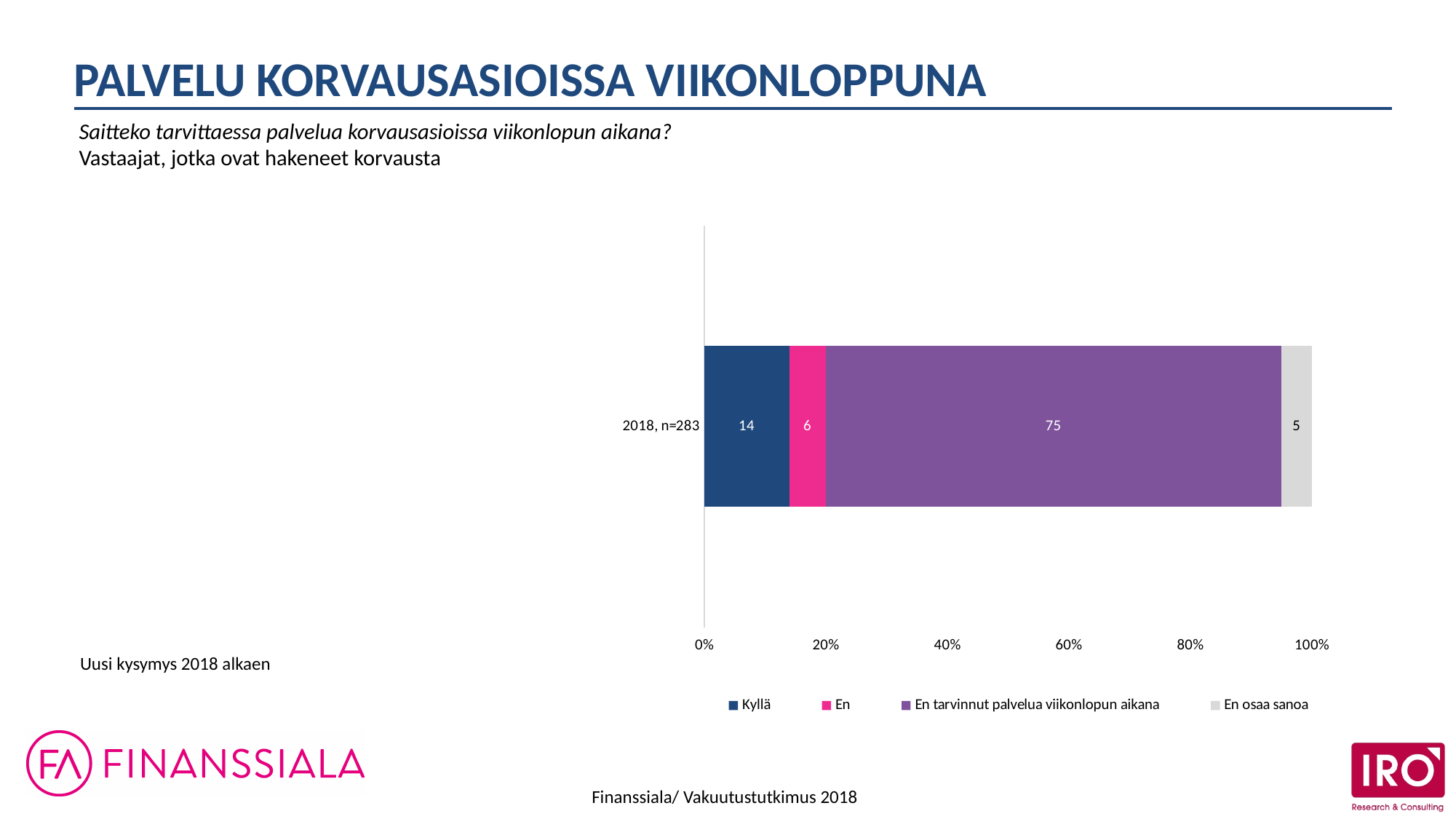
What is the total of the 2018, n=283 stacked bar? 100 Which series has the lowest value in the 2018, n=283 bar? En osaa sanoa What kind of chart is shown on the slide? Stacked bar chart Which is larger in the 2018, n=283 bar: "Kyllä" or "En osaa sanoa"? Kyllä What is the value for "En osaa sanoa" in the 2018, n=283 bar? 5 What is the value for "En" in the 2018, n=283 bar? 6 How many series does the legend list? 4 Which series has the highest value in the 2018, n=283 bar? En tarvinnut palvelua viikonlopun aikana What is the difference between the "Kyllä" and "En" values in the 2018, n=283 bar? 8 What is the value for "En tarvinnut palvelua viikonlopun aikana" in the 2018, n=283 bar? 75 What is the value for "Kyllä" in the 2018, n=283 bar? 14 What is the category label of the single bar in the chart? 2018, n=283